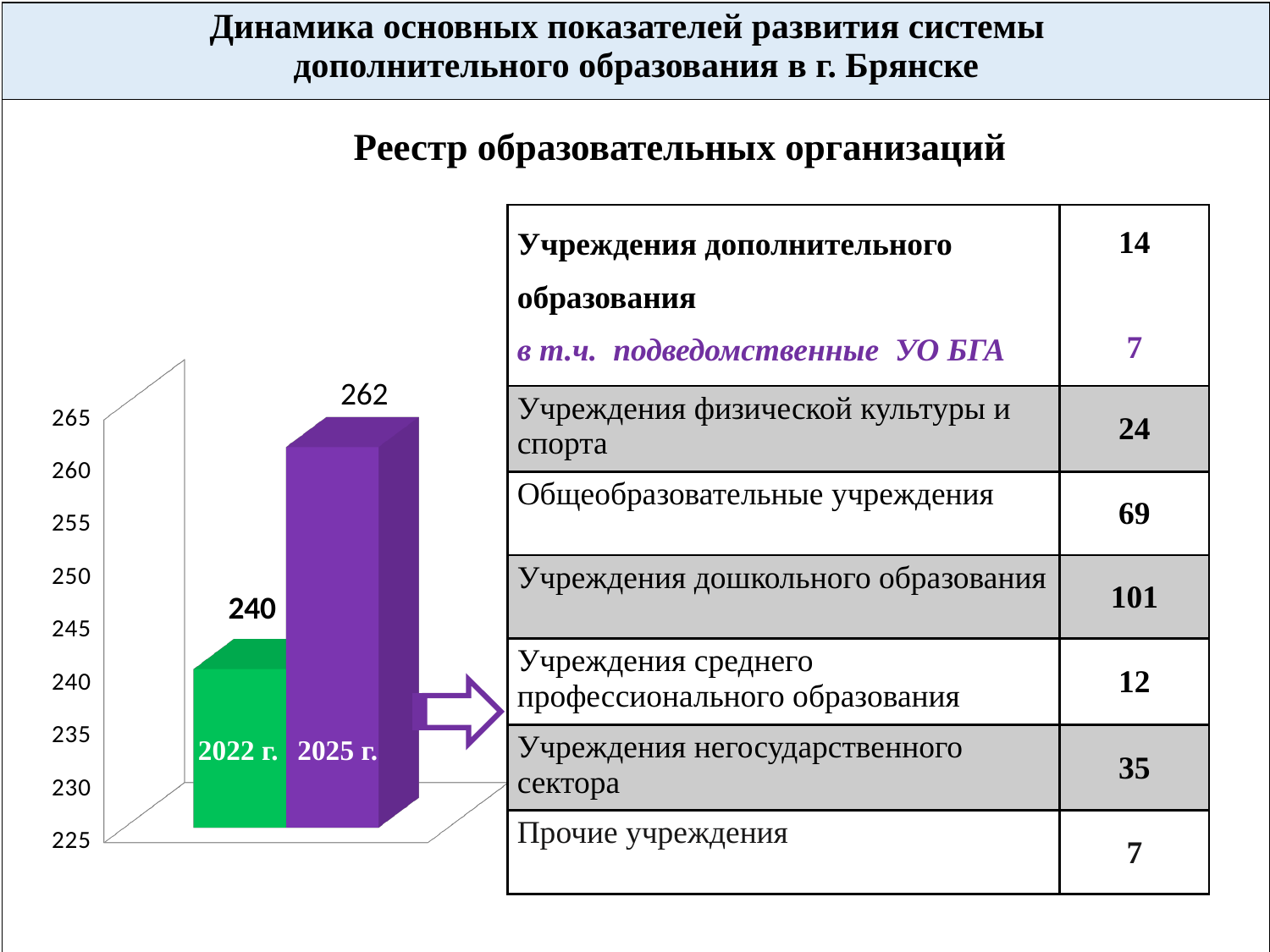
How many bars are plotted in the chart? 2 By how much does the value for 2025 г. exceed the value for 2022 г. in the bar chart? 22 Is the value for 2022 г. greater or less than 245? less What is the value shown for 2025 г. in the bar chart? 262 Is the value for 2022 г. larger or smaller than the value for 2025 г.? smaller What colour is the bar for 2025 г.? purple Do the values rise or fall from 2022 г. to 2025 г.? rise Which year has the lower value in the bar chart? 2022 г. Which year has the higher value in the bar chart? 2025 г. Is the value for 2025 г. greater or less than 250? greater What is the value shown for 2022 г. in the bar chart? 240 What kind of chart is shown on the slide? bar chart